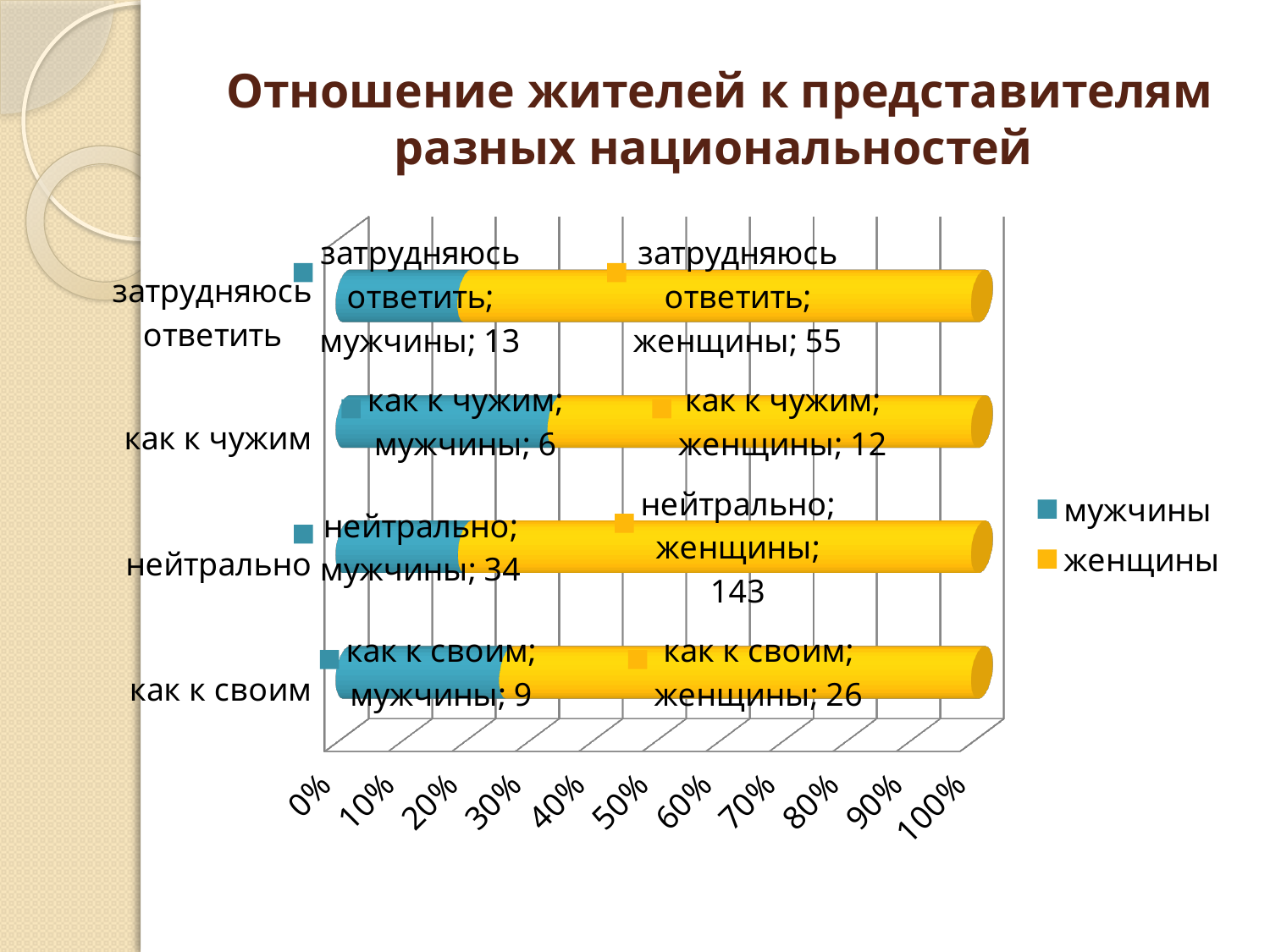
Which category has the highest value for женщины? нейтрально What is the value for мужчины in the category как к чужим? 6 Which is larger in the category как к своим: the value for мужчины or for женщины? женщины What is the value for женщины in the category затрудняюсь ответить? 55 How many series does the legend list? 2 What is the value for женщины in the category как к своим? 26 What is the difference between the женщины and мужчины values in the category нейтрально? 109 What kind of chart is shown on the slide? bar chart What is the value for мужчины in the category нейтрально? 34 How many categories are shown on the chart? 4 Which category has the lowest value for мужчины? как к чужим What is the total of the мужчины and женщины values in the category как к чужим? 18